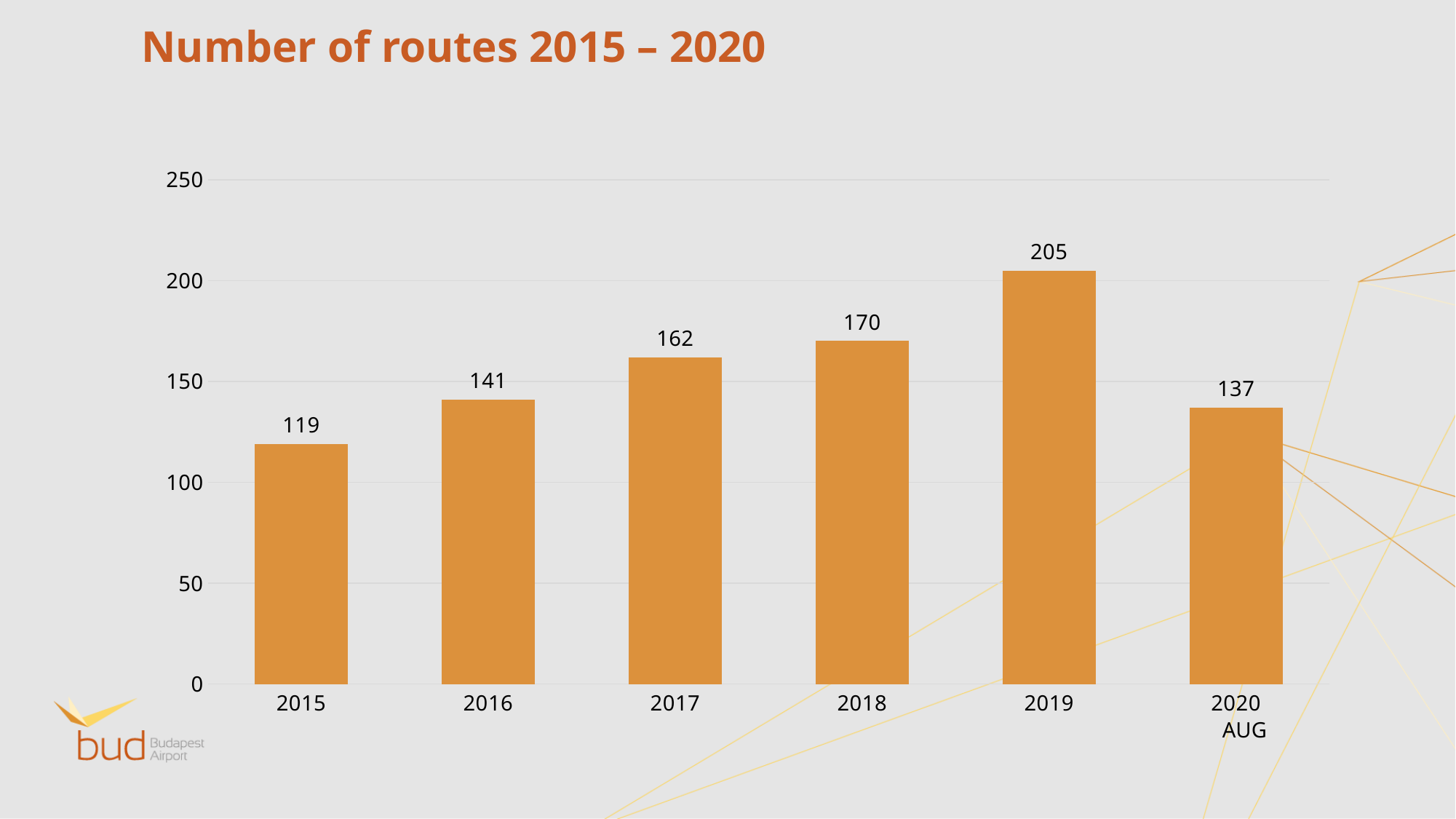
What kind of chart is shown on the slide? Bar chart What is the title of the chart? Number of routes 2015 – 2020 Is the value for 2018 greater or less than 150? greater What is the difference in the number of routes between 2019 and 2020 AUG? 68 What is the number of routes in 2015? 119 Which year has the highest number of routes? 2019 What is the difference in the number of routes between 2016 and 2015? 22 What is the number of routes in 2020 AUG? 137 How many categories are shown on the x axis? 6 What is the number of routes in 2019? 205 Which year has the lowest number of routes? 2015 Which has more routes, 2017 or 2018? 2018